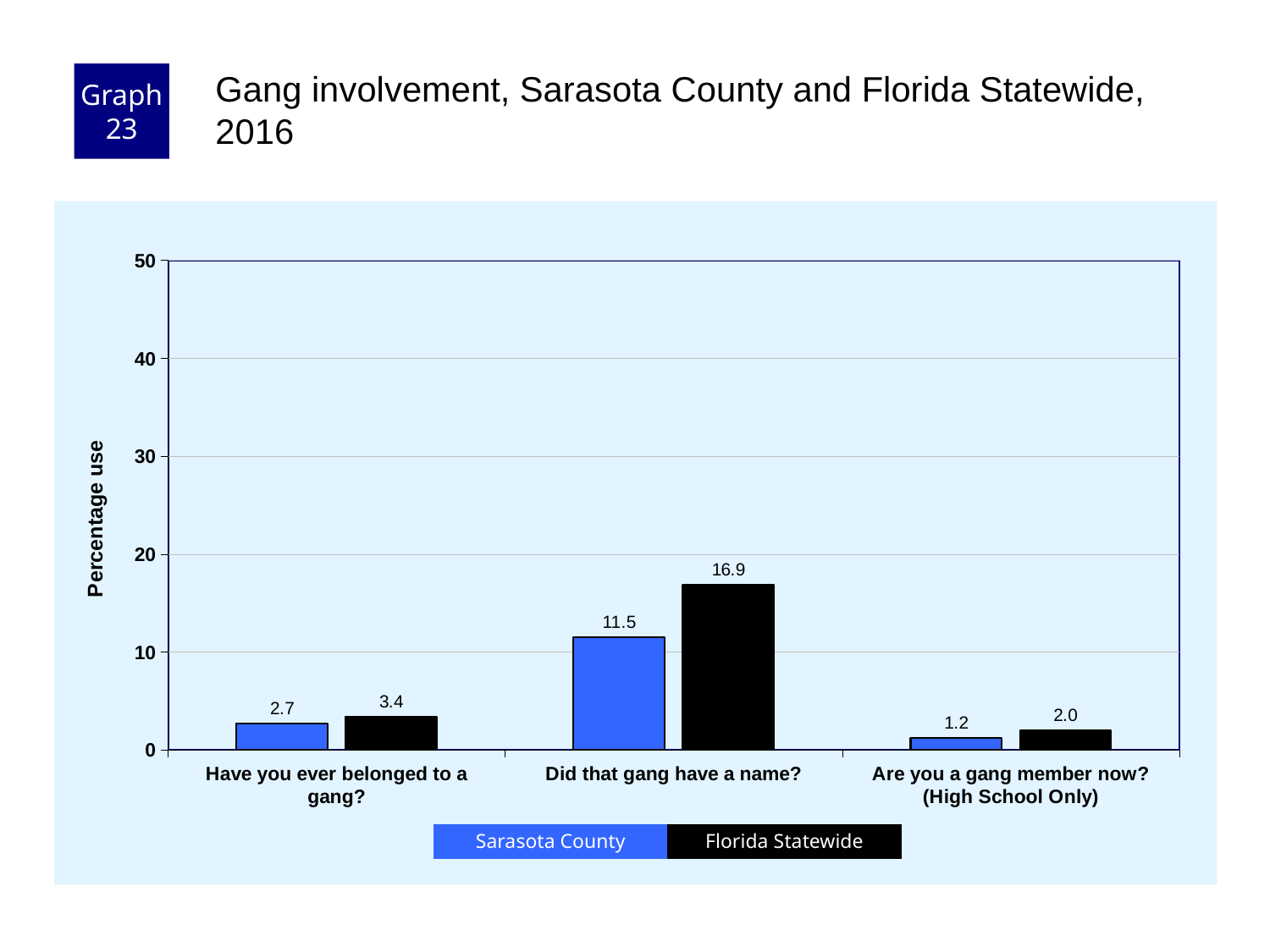
What is the Sarasota County value for "Are you a gang member now? (High School Only)"? 1.2 For "Have you ever belonged to a gang?", which is larger: Sarasota County or Florida Statewide? Florida Statewide Which question has the highest Florida Statewide value? Did that gang have a name? What kind of chart is shown? bar chart How many questions (categories) are shown on the x axis? 3 How many series does the legend list? 2 What is the Florida Statewide value for "Have you ever belonged to a gang?"? 3.4 What is the label on the y axis? Percentage use Which question has the lowest Sarasota County value? Are you a gang member now? (High School Only) What is the Sarasota County value for "Did that gang have a name?"? 11.5 Is the Florida Statewide value for "Did that gang have a name?" greater or less than 20? less What is the difference between the Florida Statewide and Sarasota County values for "Did that gang have a name?"? 5.4